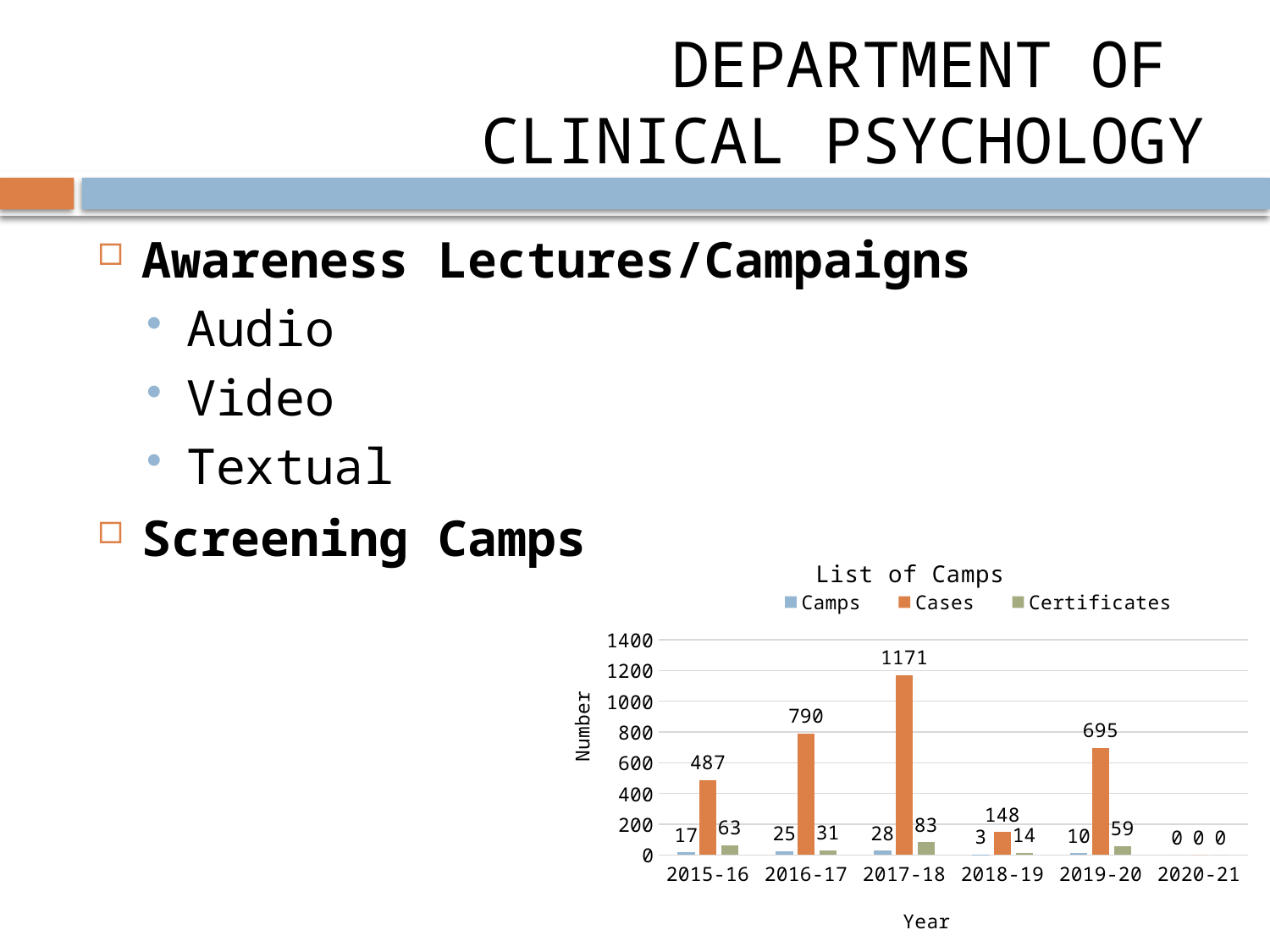
Which is larger, Cases in 2015-16 or Cases in 2019-20? Cases in 2019-20 What is the label of the y axis? Number What is the value for Camps in 2016-17? 25 Which year has the lowest value for Certificates, excluding 2020-21? 2018-19 How many years are shown on the x axis? 6 What is the value for Cases in 2017-18? 1171 How many series does the legend list? 3 What kind of chart is shown on the slide? Bar chart What is the value for Certificates in 2019-20? 59 What is the difference between Cases in 2017-18 and Cases in 2016-17? 381 What is the title of the chart? List of Camps Which year has the highest value for Cases? 2017-18